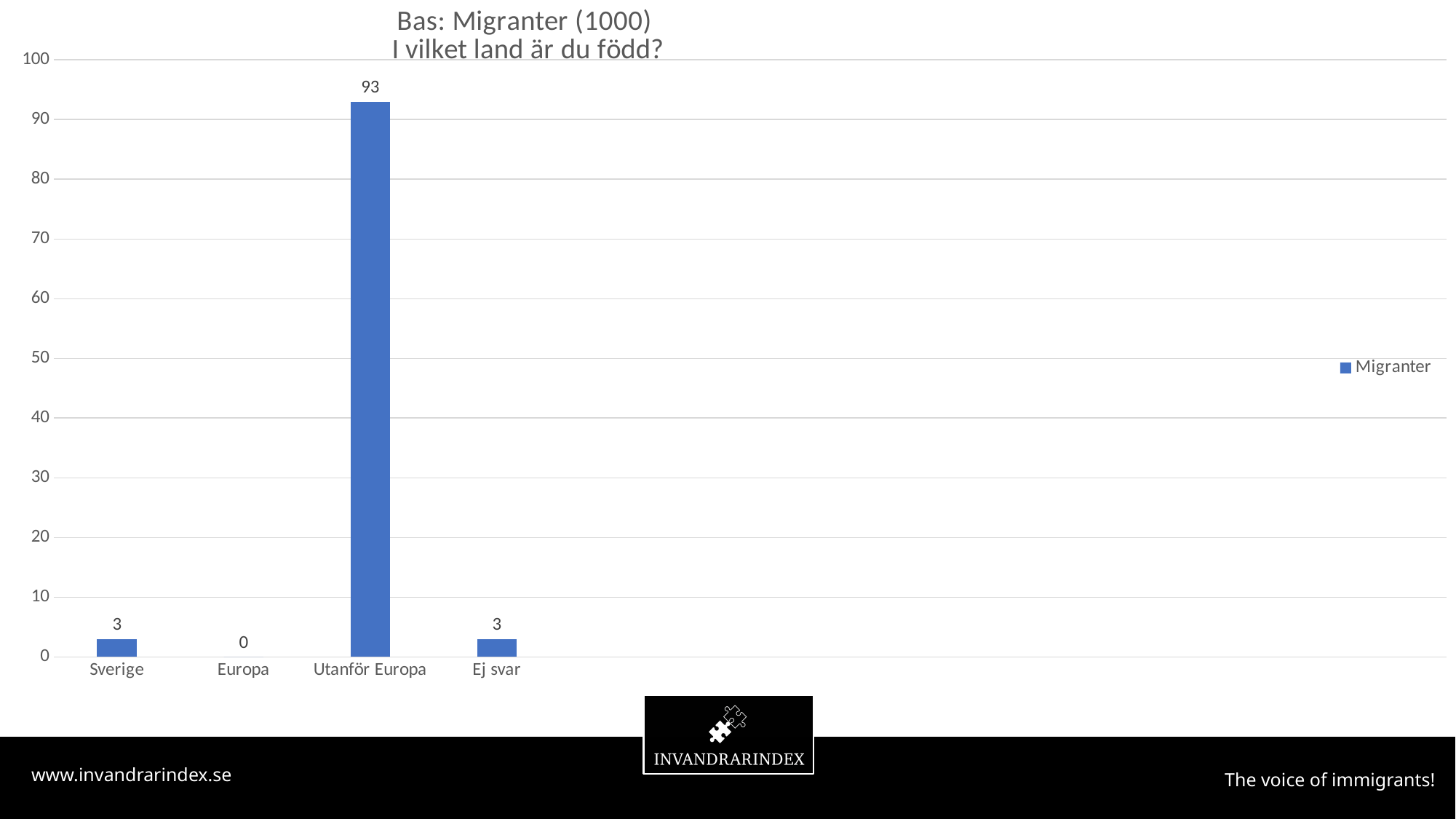
Which category has the lowest value? Europa What is the value for Ej svar? 3 What is the value for Utanför Europa? 93 Which category has the highest value? Utanför Europa Which is larger, the value for Sverige or the value for Europa? Sverige What is the difference between the values for Utanför Europa and Sverige? 90 Is the value for Utanför Europa greater or less than 50? greater What is the value for Europa? 0 What kind of chart is shown on the slide? bar chart What is the value for Sverige? 3 How many categories are shown on the x axis? 4 How many series does the legend list? 1